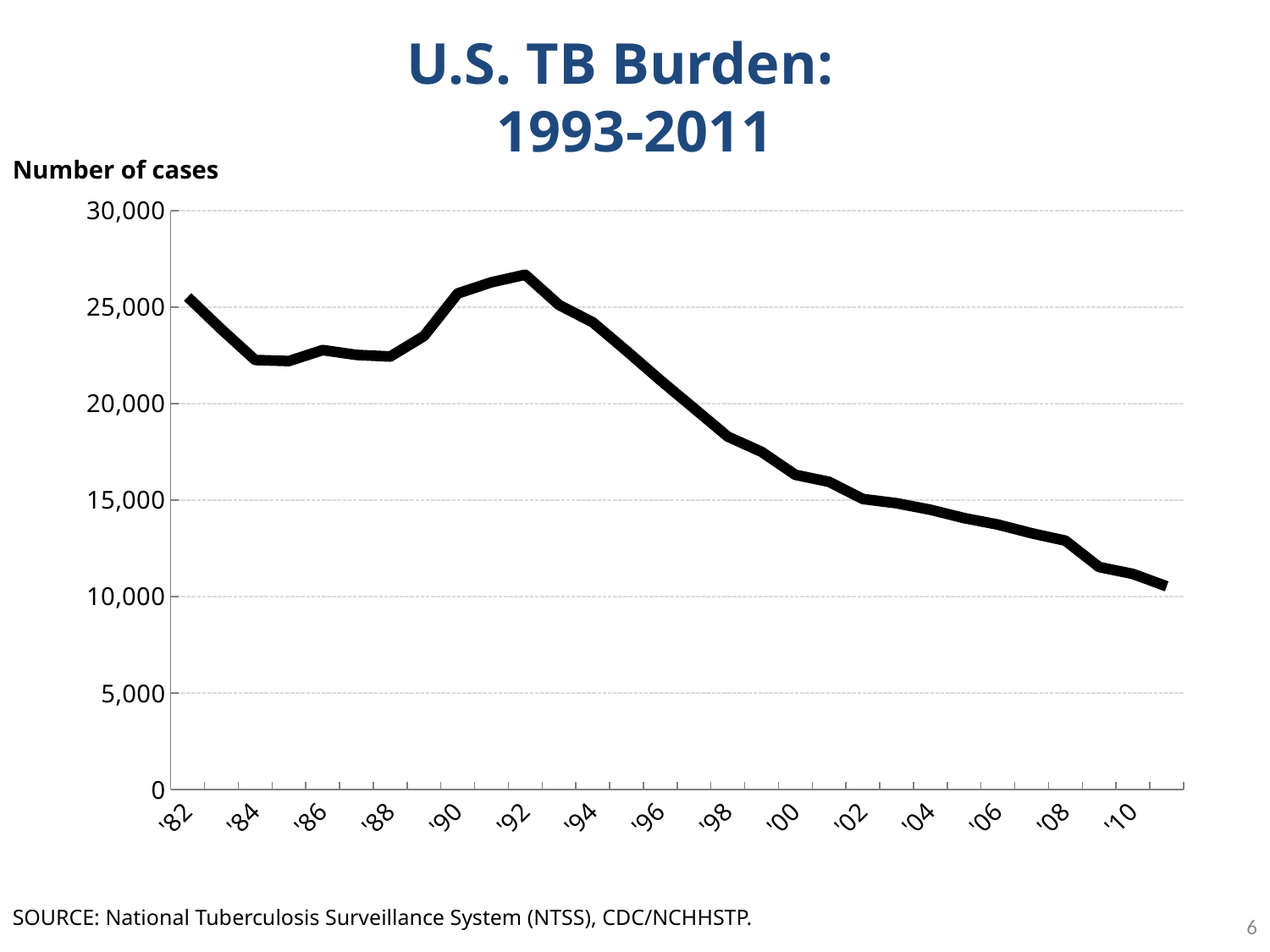
Is the number of cases in '98 greater or less than 20,000? less Is the number of cases in '08 greater or less than 15,000? less Is the number of cases in '92 greater or less than 25,000? greater What kind of chart is shown on the slide? line chart Do the number of cases rise or fall from '92 to the end of the series? fall In which year does the number of cases reach its highest point? '92 In which year is the number of cases lowest? 2011 Which year has more cases, '84 or '00? '84 What is the title of the chart? U.S. TB Burden: 1993-2011 What does the y axis of the chart measure? Number of cases